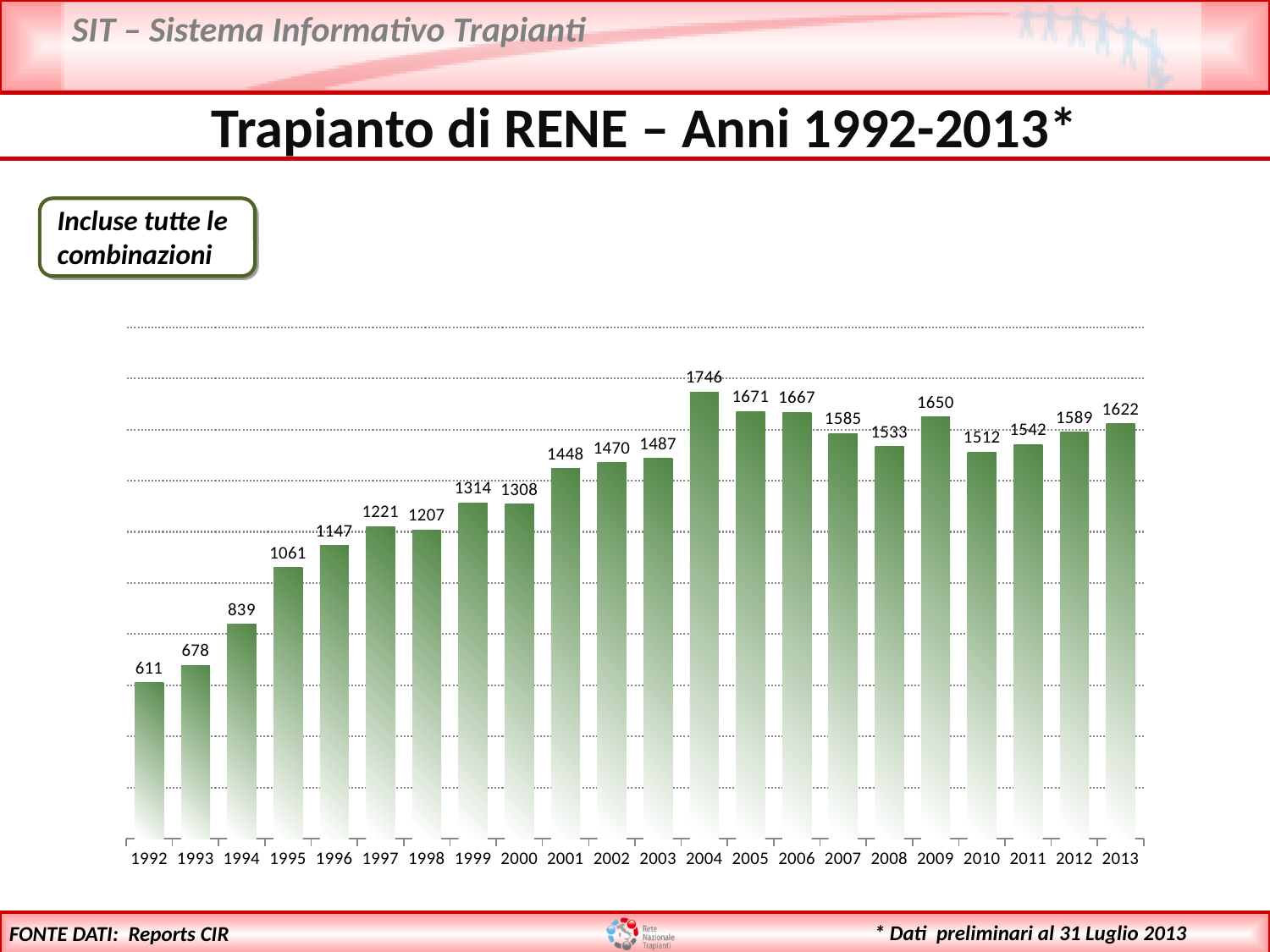
What is the value for 2004? 1746 What is the difference between the values for 2013 and 2012? 33 Which year has the highest value? 2004 What is the value for 1999? 1314 What is the difference between the values for 2004 and 1992? 1135 How many years are shown on the x axis? 22 What is the title of the slide containing the chart? Trapianto di RENE – Anni 1992-2013* Which is larger, the value for 2009 or the value for 2008? 2009 What is the value for 2013? 1622 Which year has the lowest value? 1992 What kind of chart is shown on the slide? bar chart What is the value for 1992? 611